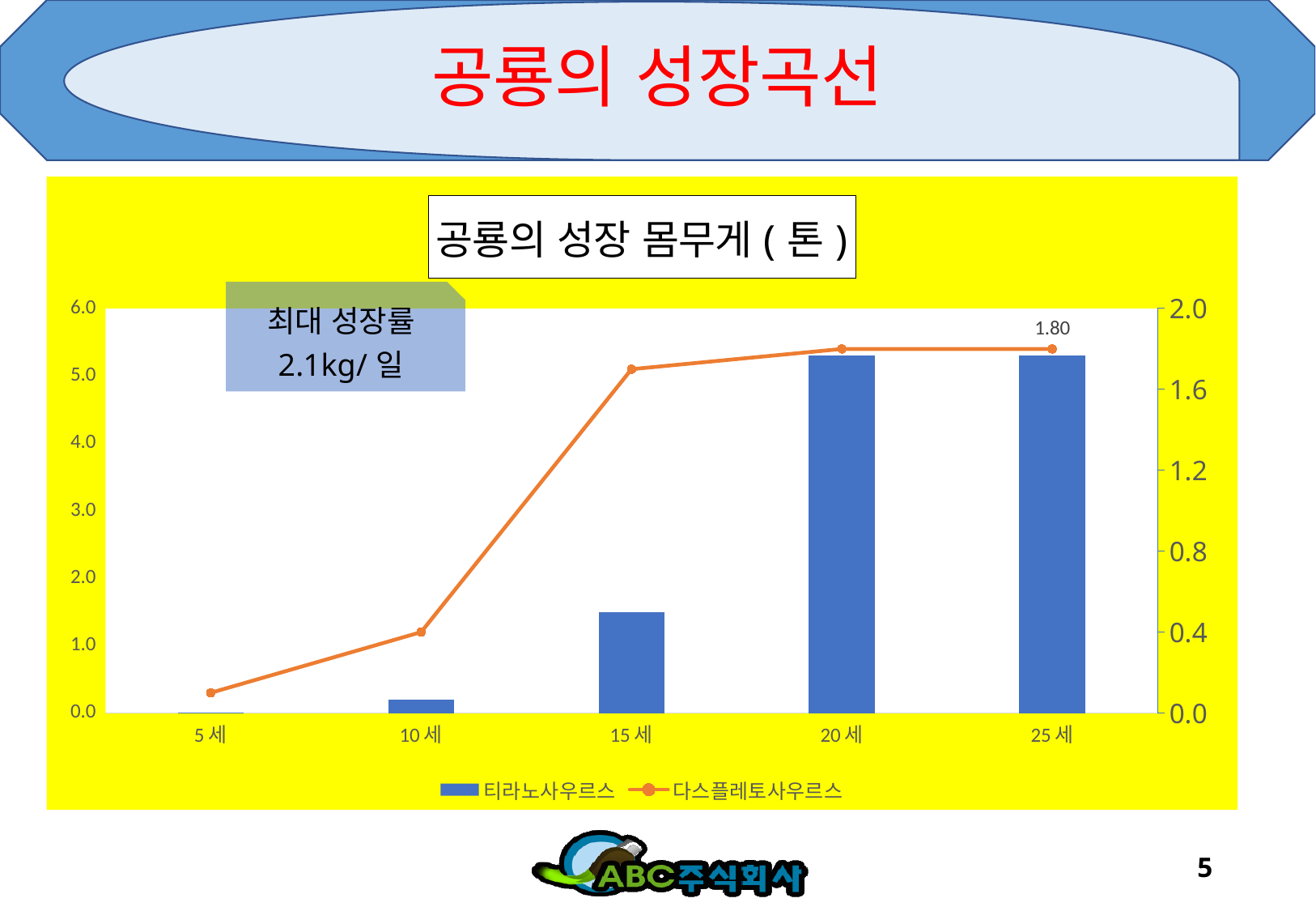
Is the value for 다스플레토사우르스 at 15 세 greater or less than 1.2 on the right axis? greater Is the value for 티라노사우르스 at 20 세 greater or less than 5.0 on the left axis? greater Which is larger for 티라노사우르스: the value at 10 세 or at 15 세? 15 세 Is the value for 티라노사우르스 at 15 세 greater or less than 2.0 on the left axis? less How many series does the legend list? 2 How many age categories are shown on the x axis? 5 What is the title of the chart? 공룡의 성장 몸무게 ( 톤 ) What kind of chart is this? Combination bar and line chart At which age is the value for 티라노사우르스 lowest? 5 세 What is the value for 다스플레토사우르스 at 25 세? 1.80 Do the values for 다스플레토사우르스 rise or fall from 5 세 to 25 세? rise